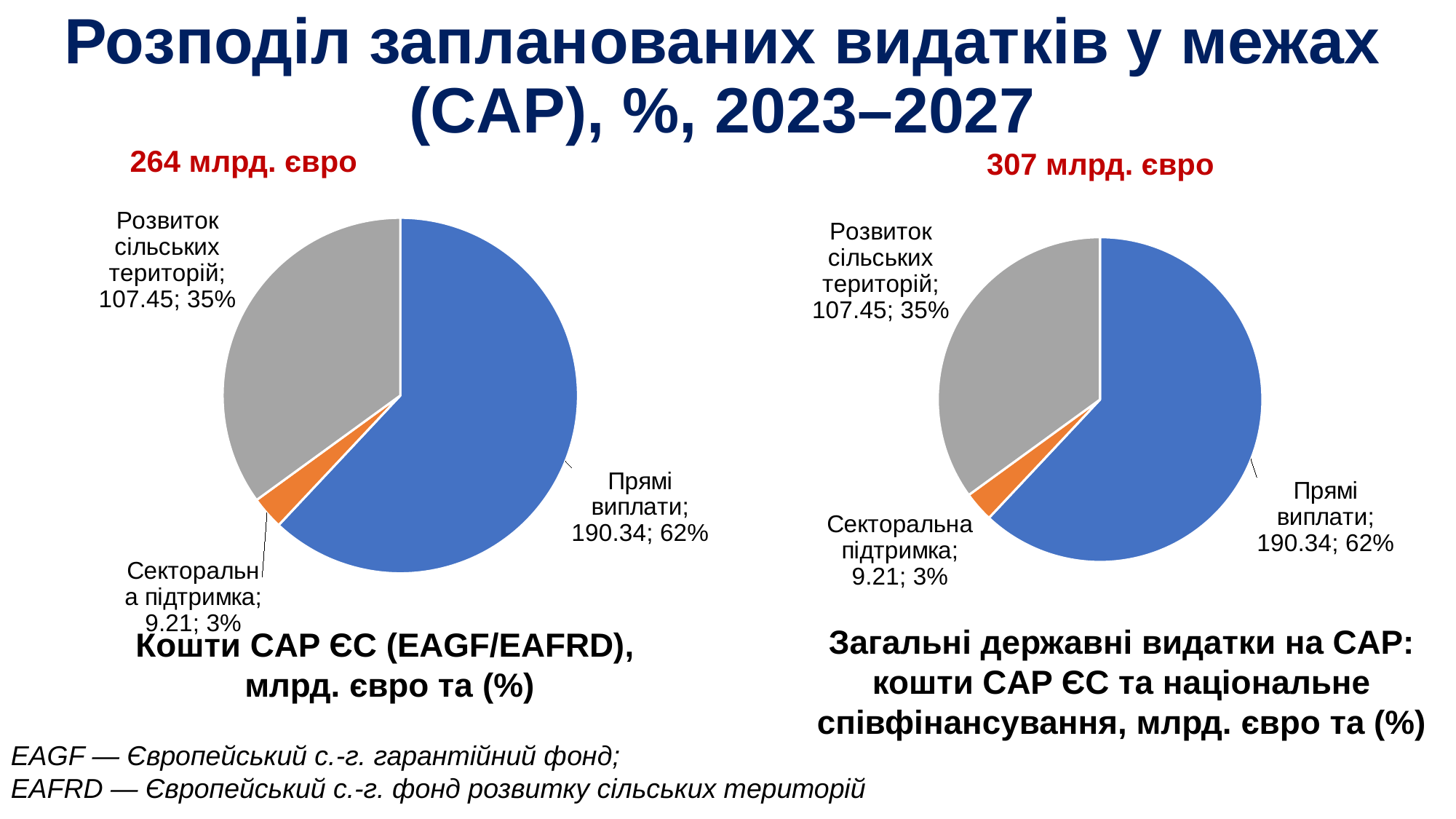
What total amount in red is shown above the left chart (Кошти CAP ЄС (EAGF/EAFRD))? 264 млрд. євро On the right chart (Загальні державні видатки на CAP), which is larger: Розвиток сільських територій or Секторальна підтримка? Розвиток сільських територій On the right chart (Загальні державні видатки на CAP), which category has the smallest slice? Секторальна підтримка What total amount in red is shown above the right chart (Загальні державні видатки на CAP)? 307 млрд. євро How many slices does the left chart (Кошти CAP ЄС (EAGF/EAFRD)) have? 3 On the right chart (Загальні державні видатки на CAP), what value is shown for Секторальна підтримка? 9.21 On the right chart (Загальні державні видатки на CAP), what share of the pie is Прямі виплати? 62% On the left chart (Кошти CAP ЄС (EAGF/EAFRD)), what value is shown for Прямі виплати? 190.34 On the left chart (Кошти CAP ЄС (EAGF/EAFRD)), what share of the pie is Розвиток сільських територій? 35% What type of chart is the right chart (Загальні державні видатки на CAP)? Pie chart On the left chart (Кошти CAP ЄС (EAGF/EAFRD)), what is the difference between the values for Прямі виплати and Розвиток сільських територій? 82.89 On the left chart (Кошти CAP ЄС (EAGF/EAFRD)), which category has the largest slice? Прямі виплати